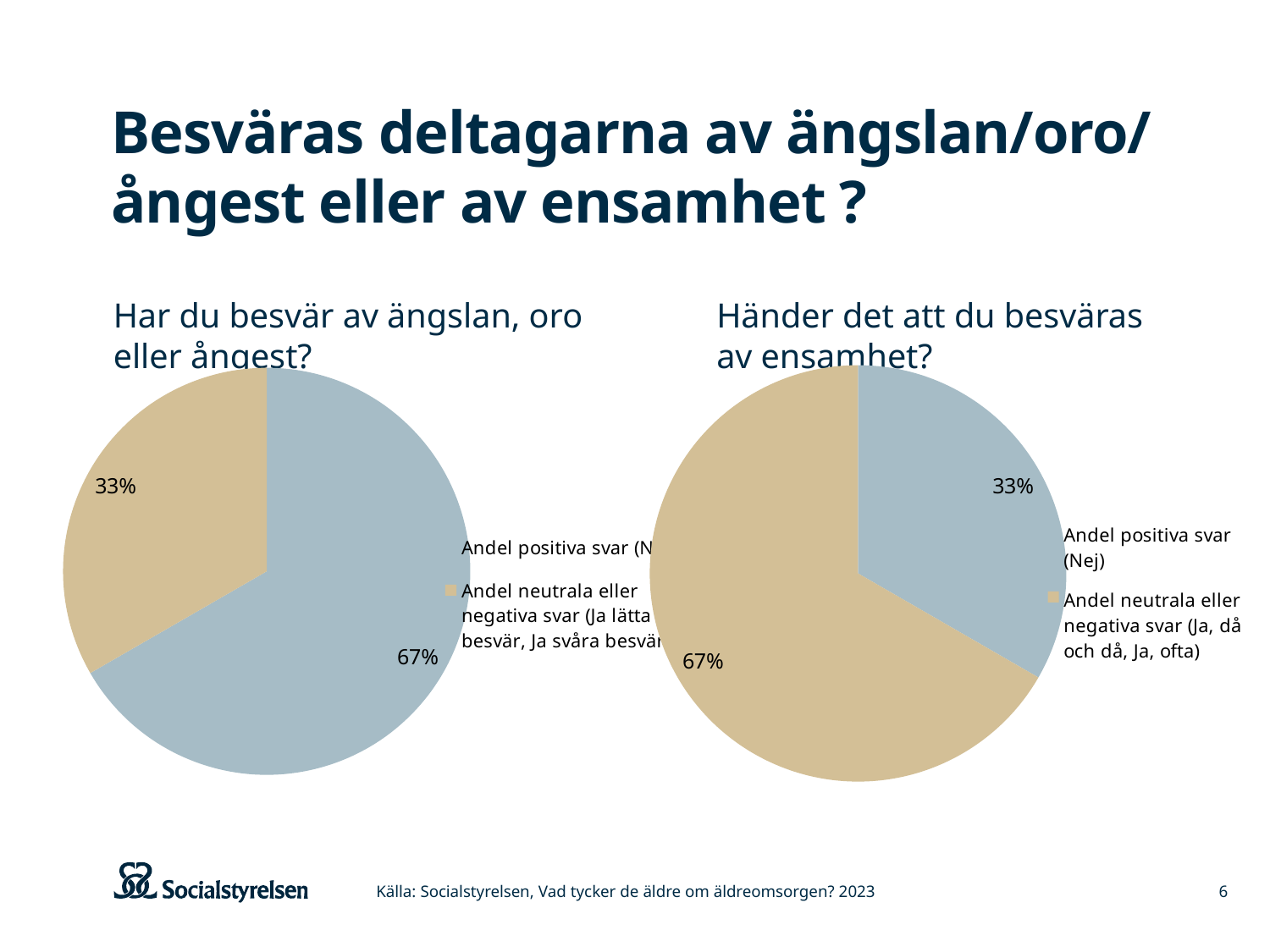
What kind of chart is used for "Har du besvär av ängslan, oro eller ångest?"? pie chart In the chart "Har du besvär av ängslan, oro eller ångest?", what share is labelled for the tan slice (Andel neutrala eller negativa svar)? 33% In the chart "Händer det att du besväras av ensamhet?", which slice is the largest? Andel neutrala eller negativa svar (Ja, då och då, Ja, ofta) How many entries does the legend of the chart "Händer det att du besväras av ensamhet?" list? 2 How many slices does the chart "Händer det att du besväras av ensamhet?" have? 2 In the chart "Har du besvär av ängslan, oro eller ångest?", is the share of Andel positiva svar larger or smaller than the share of Andel neutrala eller negativa svar? larger In the chart "Händer det att du besväras av ensamhet?", what share is labelled for Andel positiva svar (Nej)? 33% In the chart "Har du besvär av ängslan, oro eller ångest?", what share is labelled for the blue slice (Andel positiva svar)? 67% In the chart "Händer det att du besväras av ensamhet?", what share is labelled for Andel neutrala eller negativa svar (Ja, då och då, Ja, ofta)? 67% In the chart "Händer det att du besväras av ensamhet?", what is the difference in percentage points between the two slices? 34 In the chart "Har du besvär av ängslan, oro eller ångest?", which slice is the smallest? Andel neutrala eller negativa svar How many pie charts are shown on the slide? 2